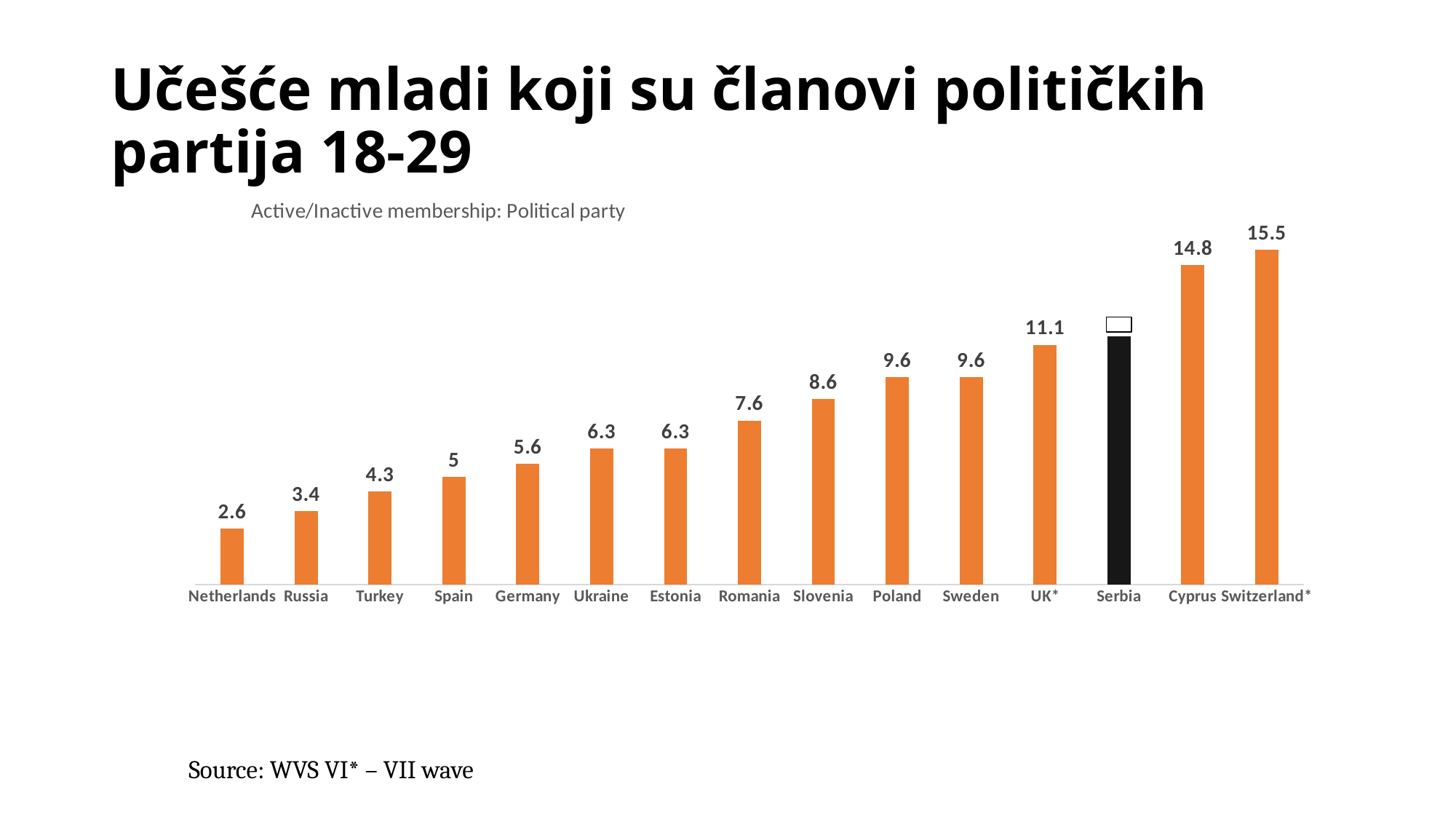
Which country has the highest value? Switzerland* What is the value for Germany? 5.6 What is the value for UK*? 11.1 Which country has the lowest value? Netherlands What is the value for Netherlands? 2.6 What is the difference between the values for Slovenia and Romania? 1 Which country's bar is coloured black instead of orange? Serbia What kind of chart is shown on the slide? Bar chart How many countries are shown in the chart? 15 What is the value for Cyprus? 14.8 What is the difference between the values for Switzerland* and Netherlands? 12.9 Which is larger, the value for Spain or the value for Turkey? Spain